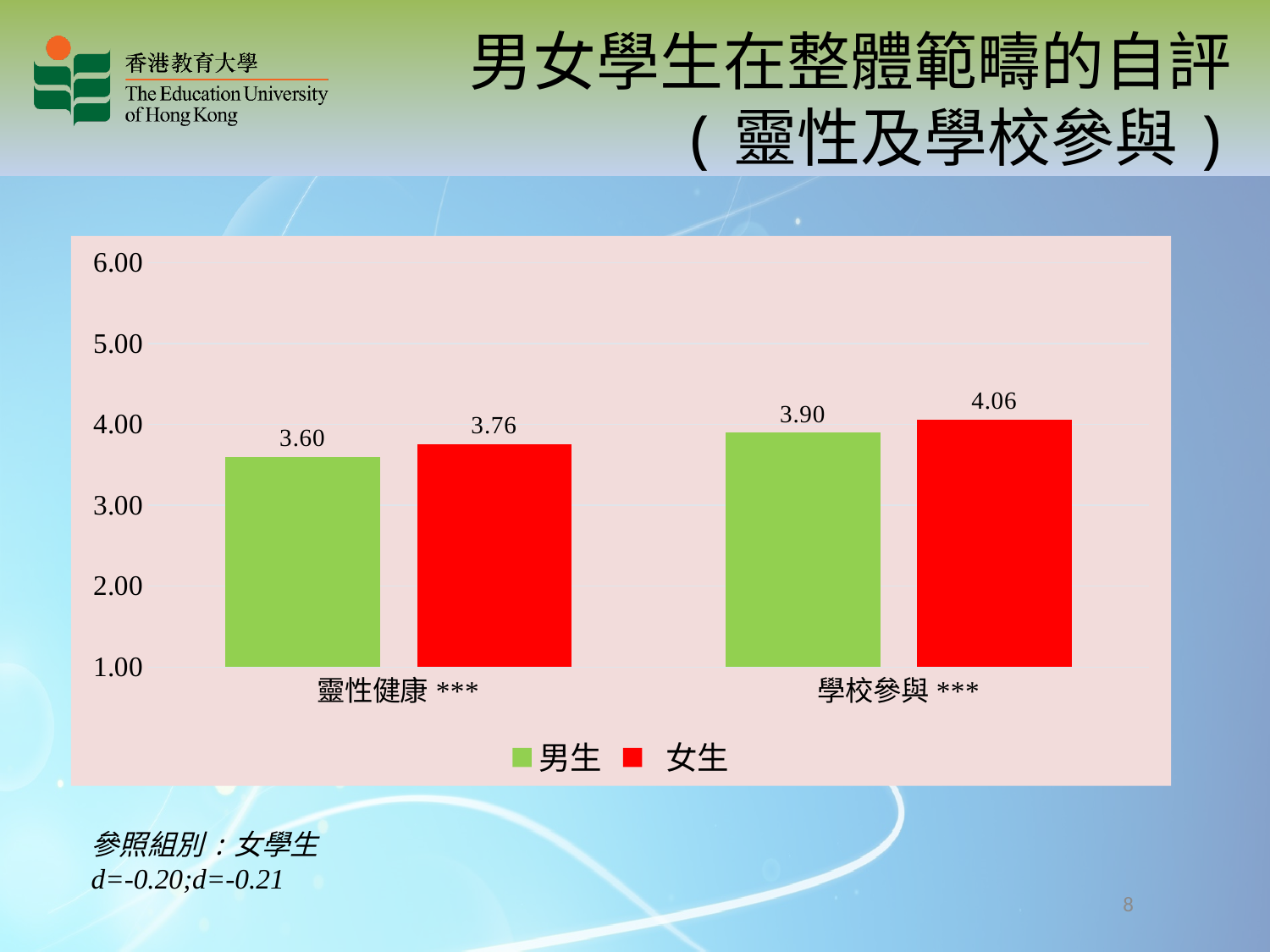
What kind of chart is shown on the slide? Bar chart Which bar has the lowest value on the chart? 男生 in 靈性健康 *** What is the value for 女生 in the 學校參與 *** category? 4.06 What is the value for 男生 in the 靈性健康 *** category? 3.60 What is the difference between the 女生 and 男生 values in the 學校參與 *** category? 0.16 What is the value for 男生 in the 學校參與 *** category? 3.90 How many categories are shown on the x axis? 2 In the 學校參與 *** category, which series has the larger value, 男生 or 女生? 女生 How many series does the legend list? 2 Which bar has the highest value on the chart? 女生 in 學校參與 *** What is the difference between the 女生 and 男生 values in the 靈性健康 *** category? 0.16 What is the value for 女生 in the 靈性健康 *** category? 3.76